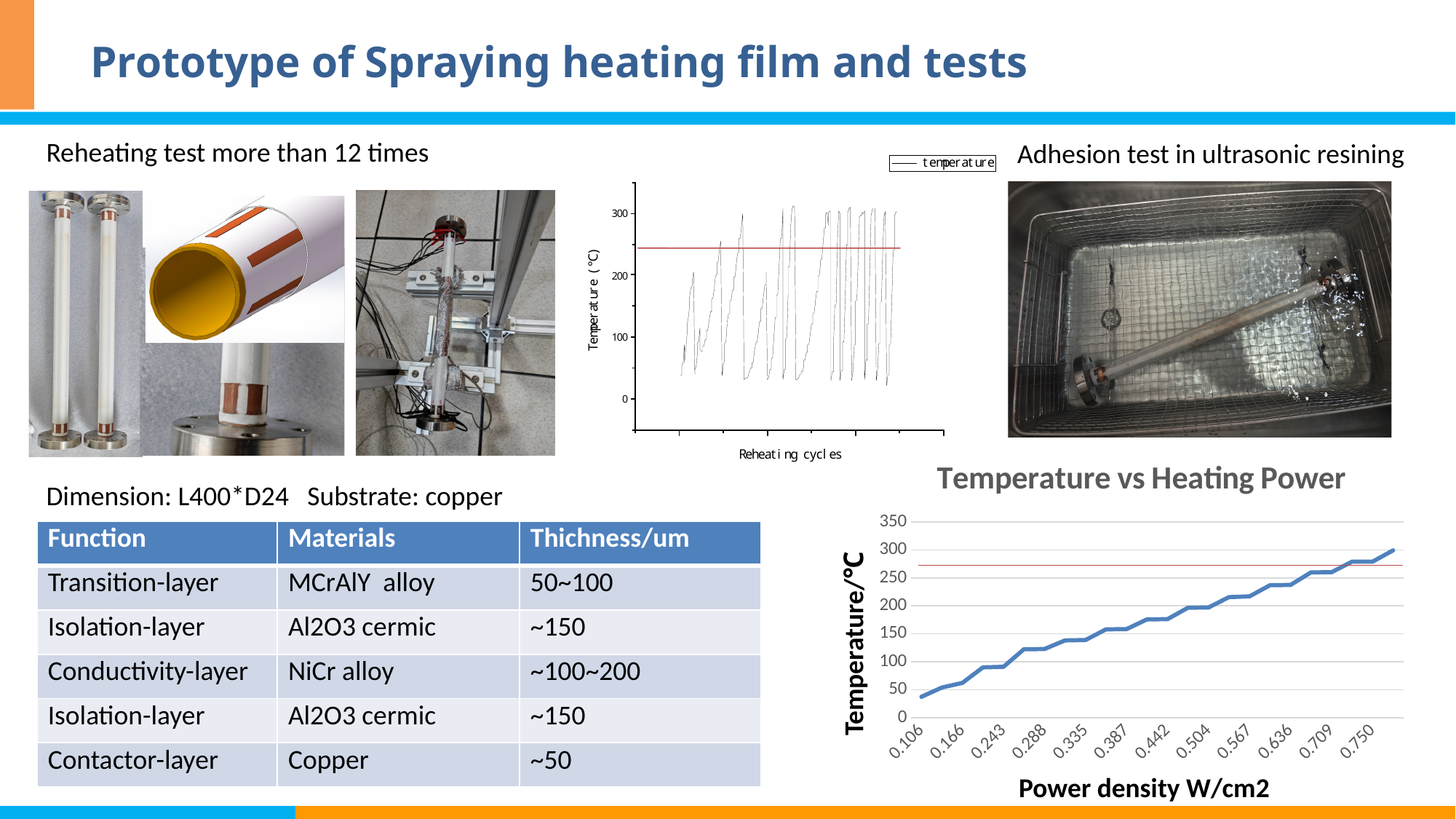
In the 'Temperature vs Heating Power' chart, is the temperature at a power density of 0.106 greater or less than 50? less What type of chart is the 'Temperature vs Heating Power' chart? line chart How many power density values are labelled on the x axis of the 'Temperature vs Heating Power' chart? 12 In the 'Temperature vs Heating Power' chart, do the temperature values rise or fall as power density increases along the x axis? rise In the 'Temperature vs Heating Power' chart, is the temperature at a power density of 0.636 greater or less than 200? greater What type of chart is the reheating cycles chart at the top of the slide? line chart In the reheating cycles chart at the top of the slide, are the peak temperatures greater or less than 250? greater In the 'Temperature vs Heating Power' chart, which power density has the highest temperature, 0.166 or 0.750? 0.750 What is the y-axis label of the reheating cycles chart at the top of the slide? Temperature (°C) What is the x-axis title of the 'Temperature vs Heating Power' chart? Power density W/cm2